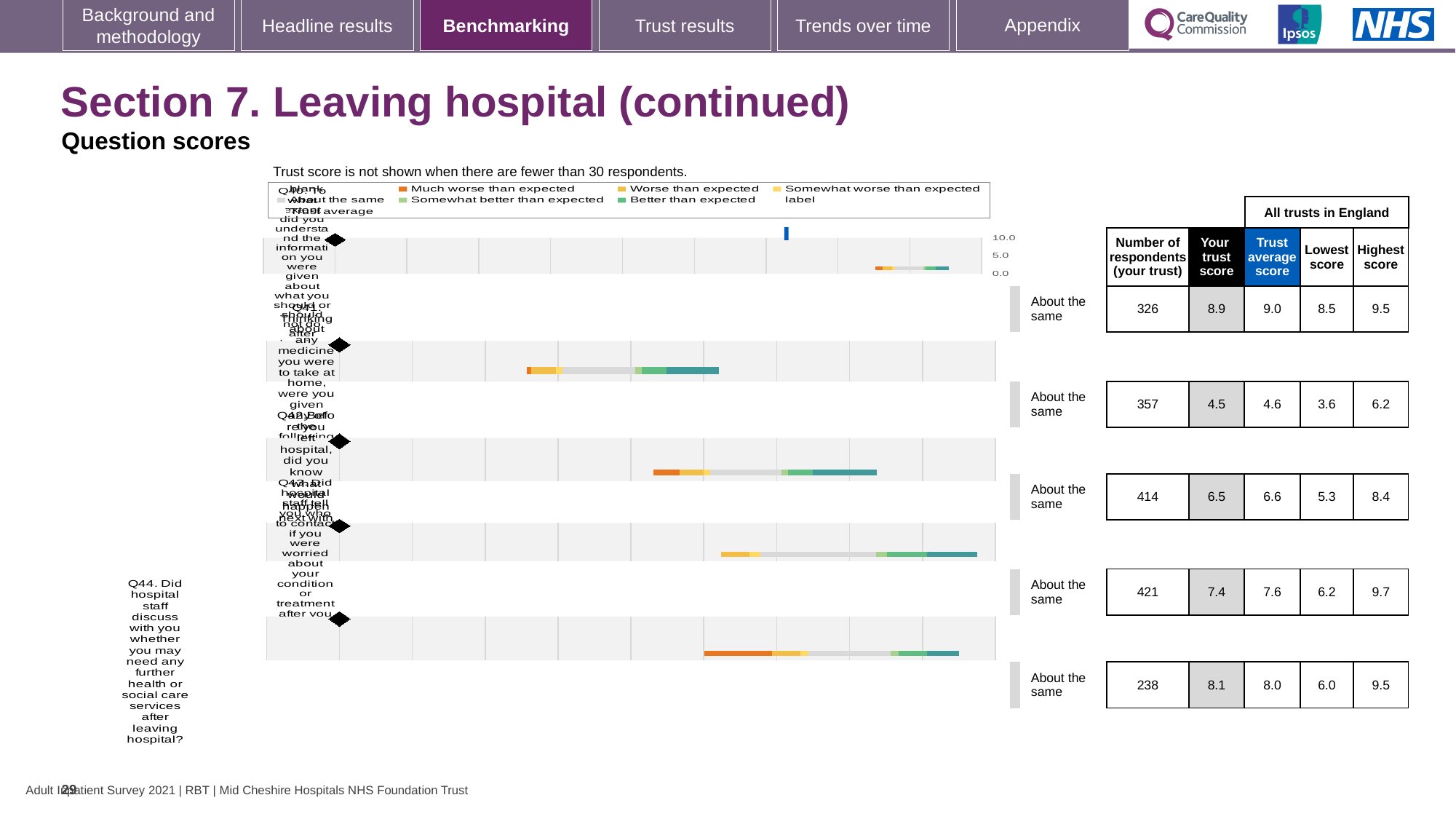
What is the trust average score for Q44 in the table? 8.0 What is the lowest 'Your trust score' shown in the table? 4.5 Which row of the table has the highest 'Your trust score', and what is it? The first row (326 respondents), 8.9 What is the 'Your trust score' for Q44 in the table? 8.1 For the row with 421 respondents, which is larger: the 'Your trust score' or the trust average score? Trust average score (7.6) How many questions (rows) are shown in the chart and table on this slide? 5 For Q44, what is the difference between the 'Your trust score' and the trust average score? 0.1 In the table, how many respondents did the trust have for Q44 (discussing whether you may need further health or social care services after leaving hospital)? 238 What is the highest score across all trusts in England for Q44? 9.5 For the question with 326 respondents (the first row of the table), what is the 'Your trust score'? 8.9 What benchmark category is shown next to every question on this slide? About the same What kind of chart is used to show the question scores on this slide? Bar chart